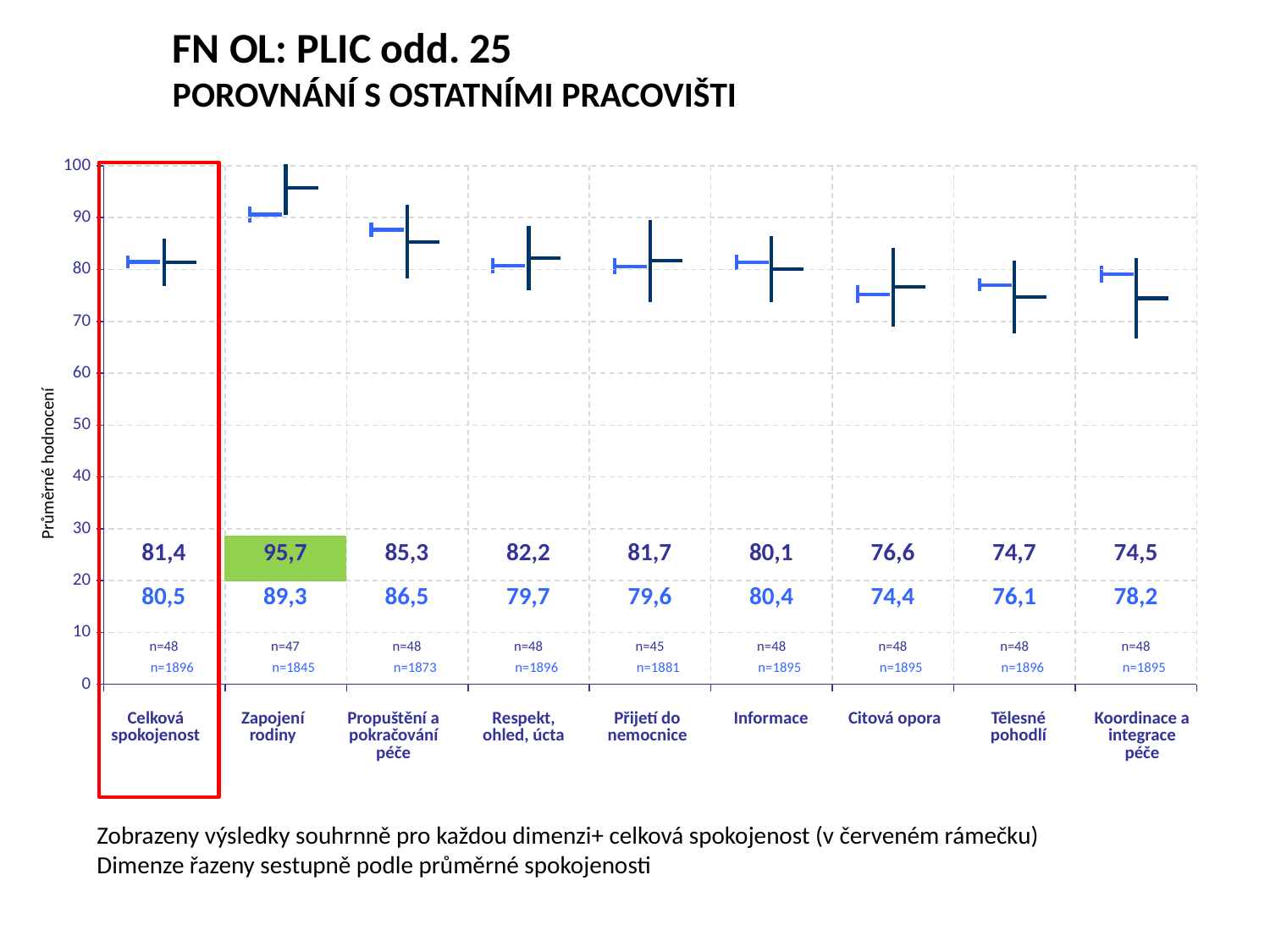
Which category has the lowest dark blue (top row) value? Koordinace a integrace péče What is the difference between the dark blue and light blue values for Zapojení rodiny? 6,4 What is the dark blue (top row) value for Zapojení rodiny? 95,7 Which category has the lowest light blue (bottom row) value? Citová opora What is the dark blue (top row) value for Celková spokojenost? 81,4 What is the light blue (bottom row) value for Citová opora? 74,4 From Zapojení rodiny to Koordinace a integrace péče, do the dark blue (top row) values rise or fall? fall For Propuštění a pokračování péče, which is larger: the dark blue value or the light blue value? the light blue value (86,5) Which category is highlighted with a red frame? Celková spokojenost What is the light blue (bottom row) value for Koordinace a integrace péče? 78,2 How many categories are shown on the x axis? 9 Which category has the highest dark blue (top row) value? Zapojení rodiny